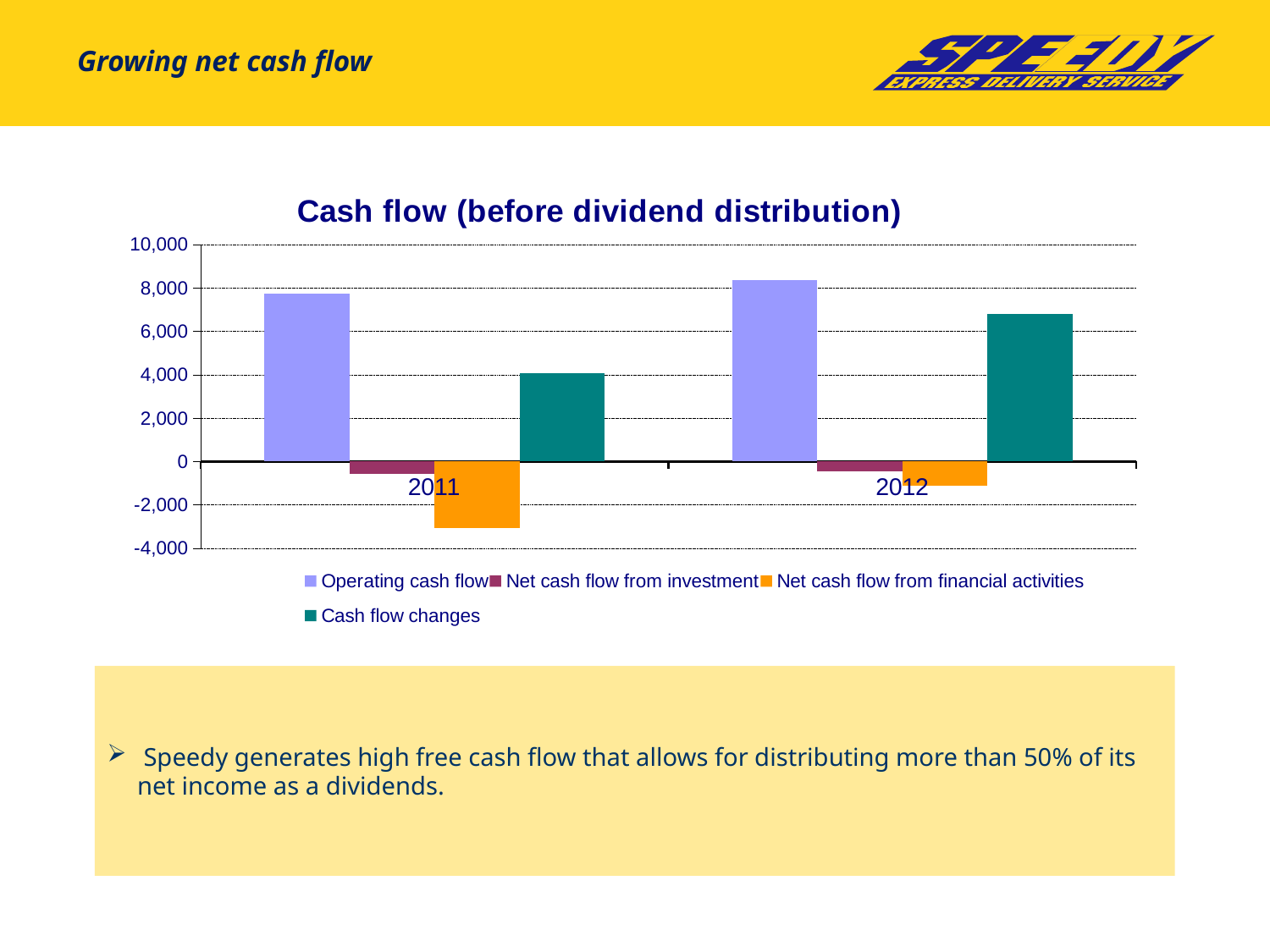
What is the title of the chart? Cash flow (before dividend distribution) Is the value for Net cash flow from financial activities in 2011 greater or less than -2,000? less What kind of chart is shown on the slide? Bar chart Which year has the larger Cash flow changes value, 2011 or 2012? 2012 Which year has the larger Operating cash flow, 2011 or 2012? 2012 Is the value for Cash flow changes in 2011 greater or less than 2,000? greater Which series has the highest value in 2012? Operating cash flow Which series has the lowest value in 2011? Net cash flow from financial activities How many series does the chart legend list? 4 Is the value for Operating cash flow in 2011 greater or less than 6,000? greater How many years are shown on the x axis of the chart? 2